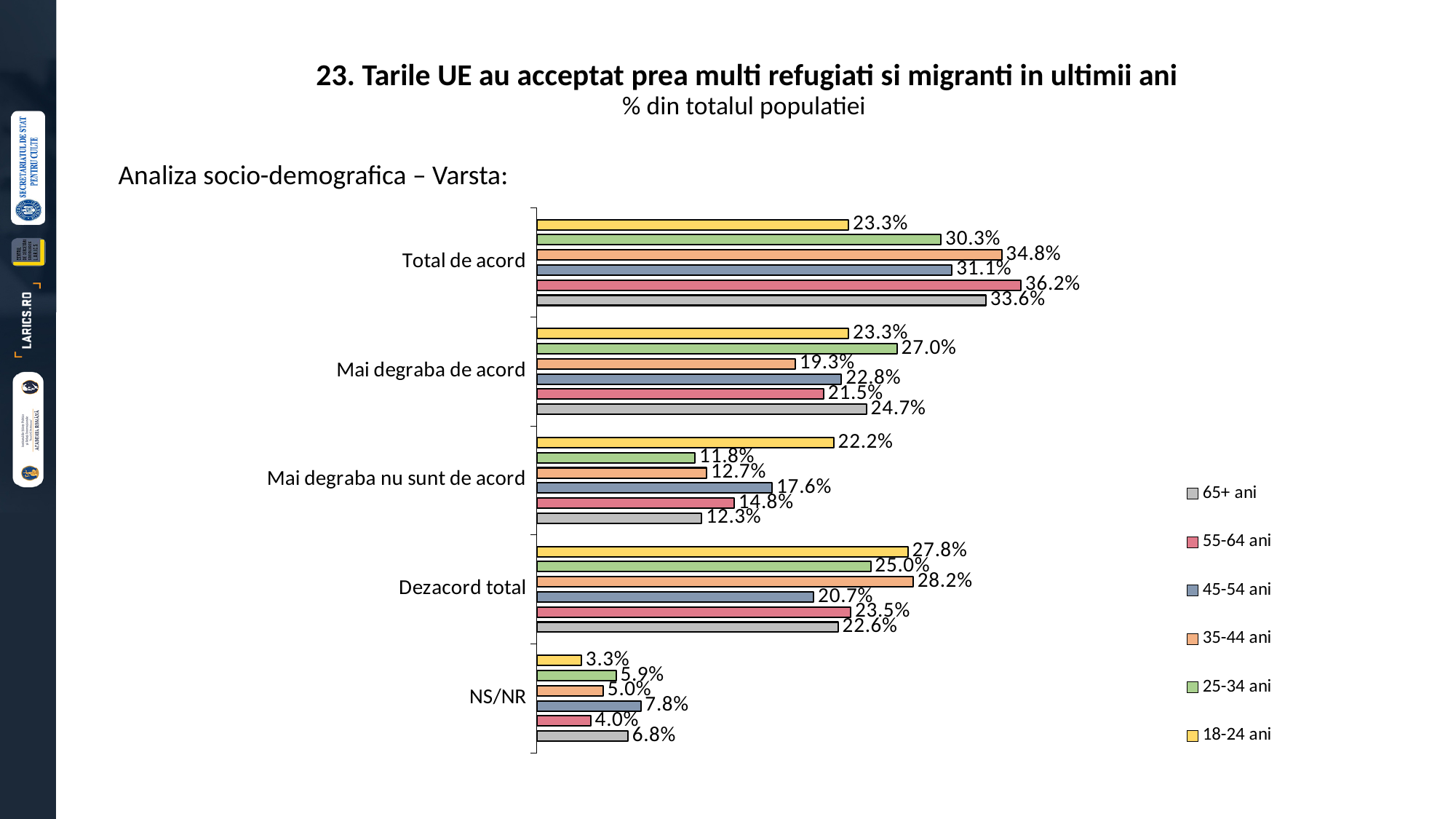
What kind of chart is shown on the slide? bar chart In the Mai degraba de acord category, which is larger: the value for 25-34 ani or the value for 35-44 ani? 25-34 ani How many series does the legend list? 6 What is the value for the 55-64 ani series in the Total de acord category? 36.2% Which age group has the highest value in the Dezacord total category? 35-44 ani How many response categories are shown on the chart? 5 What is the value for the 18-24 ani series in the Mai degraba nu sunt de acord category? 22.2% What is the value for the 45-54 ani series in the NS/NR category? 7.8% Which age group has the highest value in the Total de acord category? 55-64 ani What is the subtitle shown under the chart title? % din totalul populatiei What is the difference between the 35-44 ani and 45-54 ani values in the Dezacord total category? 7.5% Which age group has the lowest value in the NS/NR category? 18-24 ani